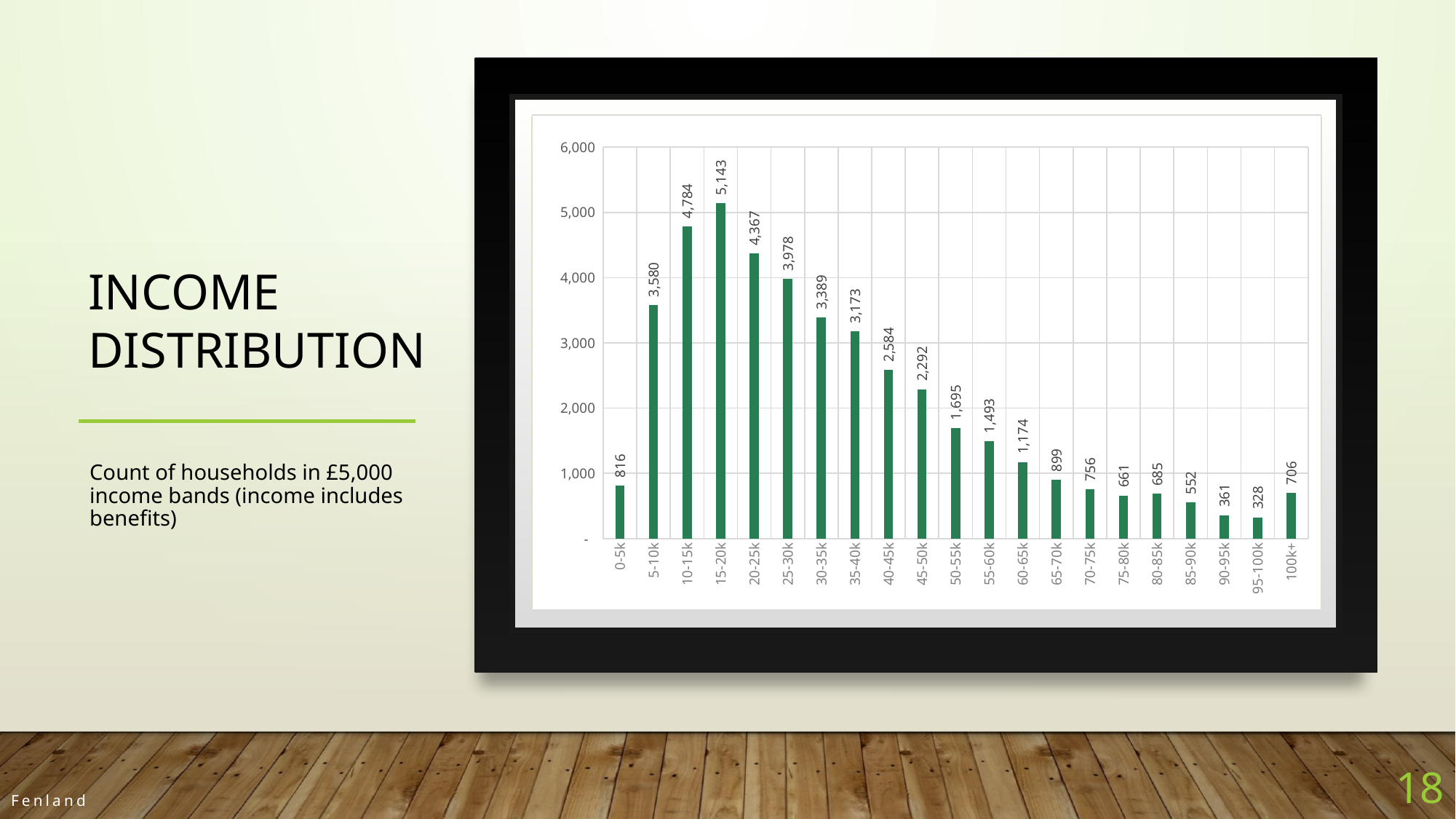
Which income band has more households, 40-45k or 45-50k? 40-45k Which income band has the highest count of households? 15-20k What is the count of households in the 15-20k income band? 5,143 What is the difference between the counts for the 5-10k and 0-5k income bands? 2,764 How many income bands are shown on the chart? 21 Which income band has the lowest count of households? 95-100k What is the count of households in the 100k+ income band? 706 What is the count of households in the 0-5k income band? 816 What kind of chart is shown on the slide? Bar chart Do the household counts rise or fall from the 15-20k band to the 95-100k band? Fall Is the value for the 25-30k income band greater or less than 3,000? greater What is the difference between the counts for the 15-20k and 10-15k income bands? 359